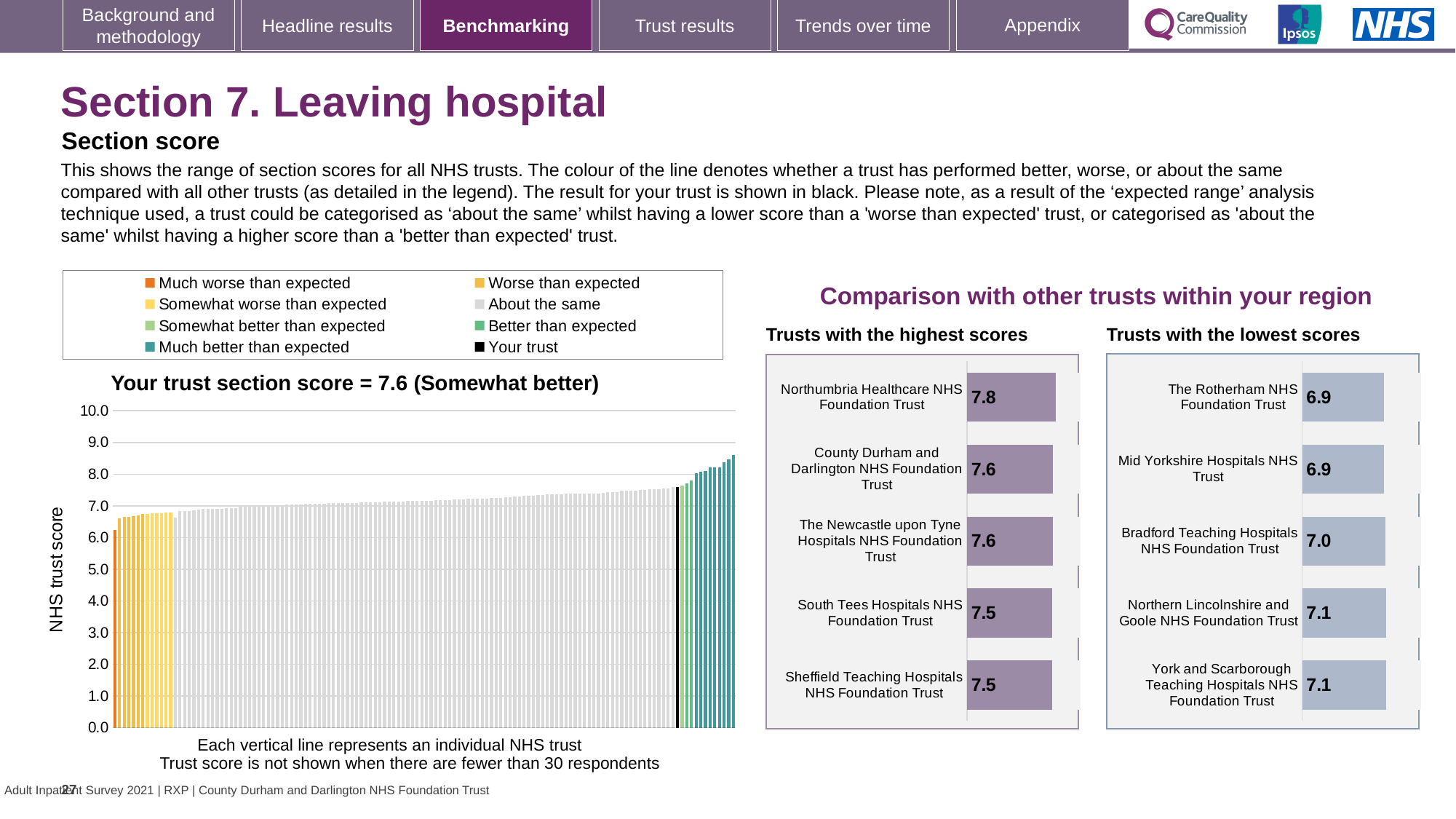
On the 'Trusts with the lowest scores' chart, which is larger: the score for Bradford Teaching Hospitals NHS Foundation Trust or The Rotherham NHS Foundation Trust? Bradford Teaching Hospitals NHS Foundation Trust On the 'Trusts with the highest scores' chart, what is the score for South Tees Hospitals NHS Foundation Trust? 7.5 On the 'Trusts with the lowest scores' chart, what is the score for York and Scarborough Teaching Hospitals NHS Foundation Trust? 7.1 On the 'Trusts with the highest scores' chart, what is the difference between the scores of Northumbria Healthcare NHS Foundation Trust and Sheffield Teaching Hospitals NHS Foundation Trust? 0.3 On the 'Trusts with the highest scores' chart, how many trusts are listed? 5 What kind of chart is the left-hand chart showing the range of section scores for all NHS trusts? Bar chart On the 'Trusts with the lowest scores' chart, what is the difference between the scores of Northern Lincolnshire and Goole NHS Foundation Trust and Mid Yorkshire Hospitals NHS Trust? 0.2 On the 'Trusts with the highest scores' chart, which trust has the highest score? Northumbria Healthcare NHS Foundation Trust On the 'Trusts with the highest scores' chart, what is the score for Northumbria Healthcare NHS Foundation Trust? 7.8 On the left-hand chart of all NHS trusts, what is your trust's section score as stated in the chart title? 7.6 On the left-hand chart of all NHS trusts, do the trust scores rise or fall from left to right along the x axis? Rise On the 'Trusts with the lowest scores' chart, what is the score for Bradford Teaching Hospitals NHS Foundation Trust? 7.0